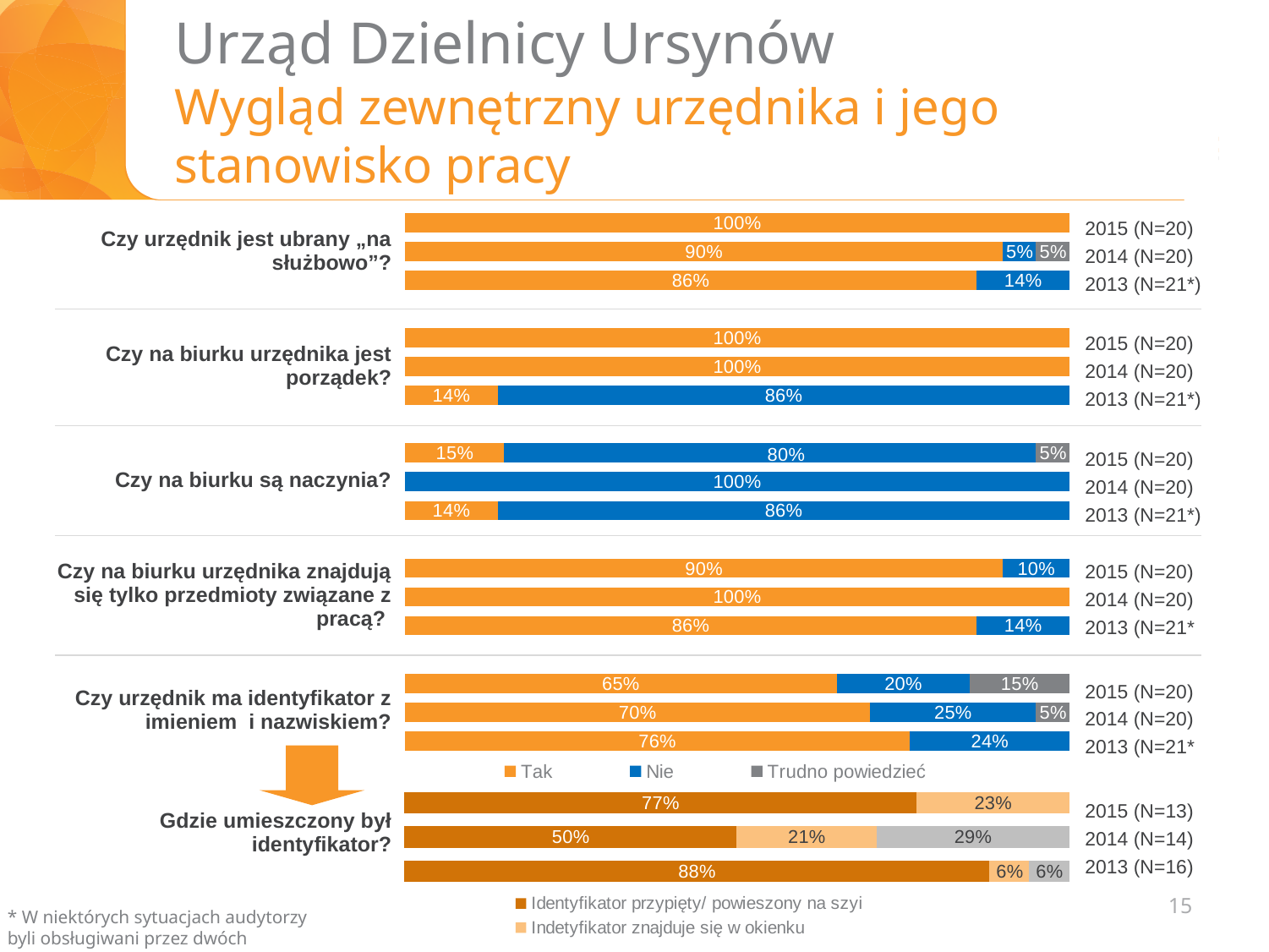
In the chart for "Czy urzędnik jest ubrany „na służbowo”?", what is the "Tak" value for 2013 (N=21*)? 86% In the chart for "Czy urzędnik ma identyfikator z imieniem i nazwiskiem?", does the "Tak" value rise or fall from 2013 to 2015? fall In the chart for "Czy urzędnik ma identyfikator z imieniem i nazwiskiem?", by how many percentage points is the "Tak" value for 2013 higher than for 2015? 11 percentage points In the legend with "Tak", "Nie" and "Trudno powiedzieć", what colour represents "Tak"? orange What kind of chart is used on this slide? bar chart In the chart for "Czy urzędnik jest ubrany „na służbowo”?", which year has the highest "Tak" value? 2015 (N=20) In the chart for "Czy na biurku są naczynia?", what is the "Nie" value for 2015 (N=20)? 80% In the chart for "Czy na biurku urzędnika jest porządek?", which is larger for 2013 (N=21*): "Tak" or "Nie"? Nie In the chart for "Gdzie umieszczony był identyfikator?", what is the value for "Identyfikator przypięty/ powieszony na szyi" in 2014 (N=14)? 50% In the chart for "Czy urzędnik ma identyfikator z imieniem i nazwiskiem?", what is the "Nie" value for 2014 (N=20)? 25% In the chart for "Gdzie umieszczony był identyfikator?", what is the value for "Indetyfikator znajduje się w okienku" in 2015 (N=13)? 23% How many series does the legend with "Tak", "Nie" and "Trudno powiedzieć" list? 3